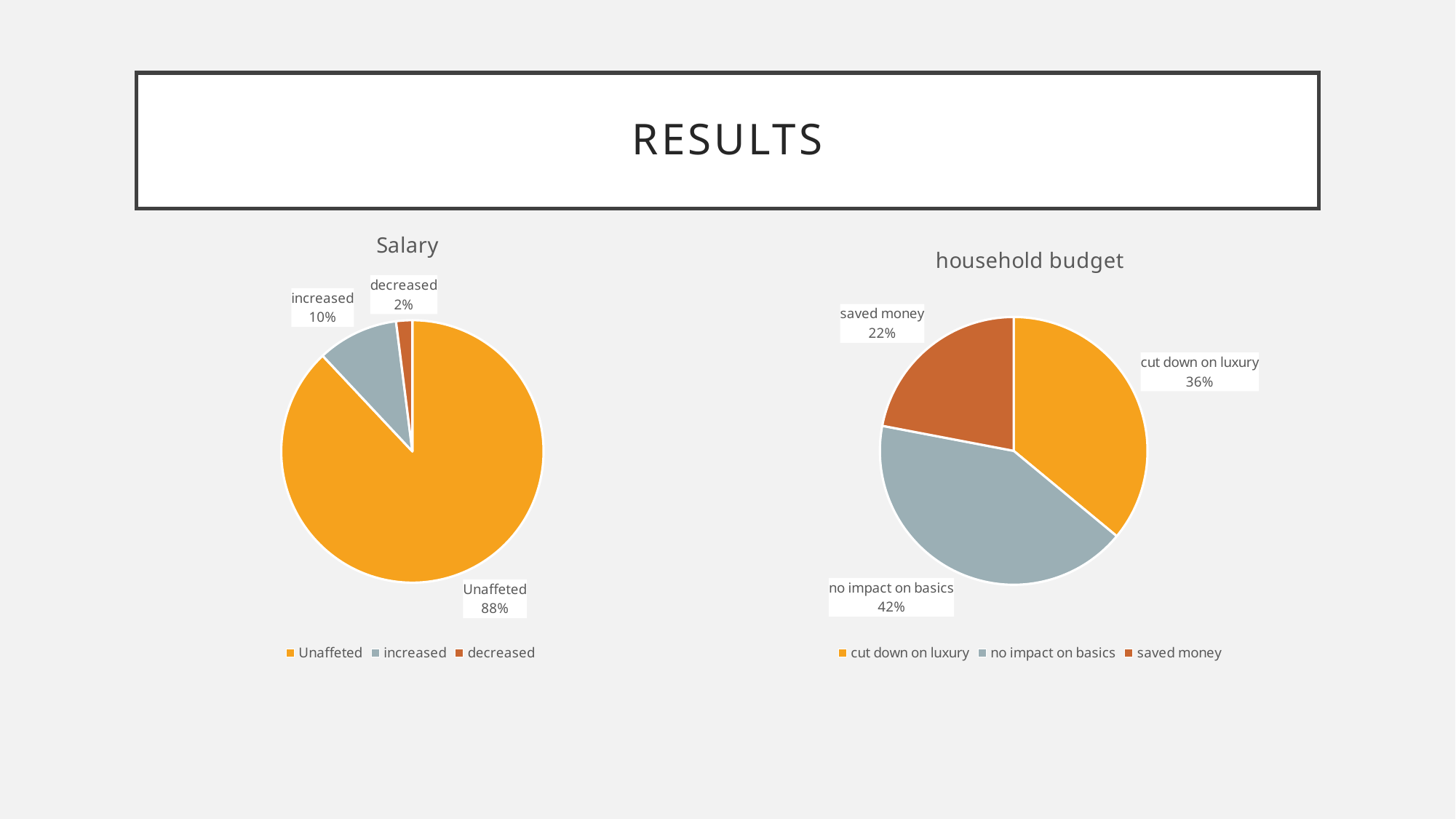
In the household budget chart, what is the difference between cut down on luxury and saved money? 14% How many entries does the legend of the household budget chart list? 3 In the Salary chart, which category has the smallest slice? decreased In the household budget chart, which category has the smallest slice? saved money In the household budget chart, what percentage is shown for no impact on basics? 42% What type of chart is the household budget chart? Pie chart In the Salary chart, what is the difference between the increased and decreased percentages? 8% In the Salary chart, how many slices does the pie have? 3 In the household budget chart, which is larger: cut down on luxury or no impact on basics? no impact on basics In the Salary chart, what percentage is shown for increased? 10% In the household budget chart, which category has the largest slice? no impact on basics In the Salary chart, what share of the pie is labelled Unaffeted? 88%